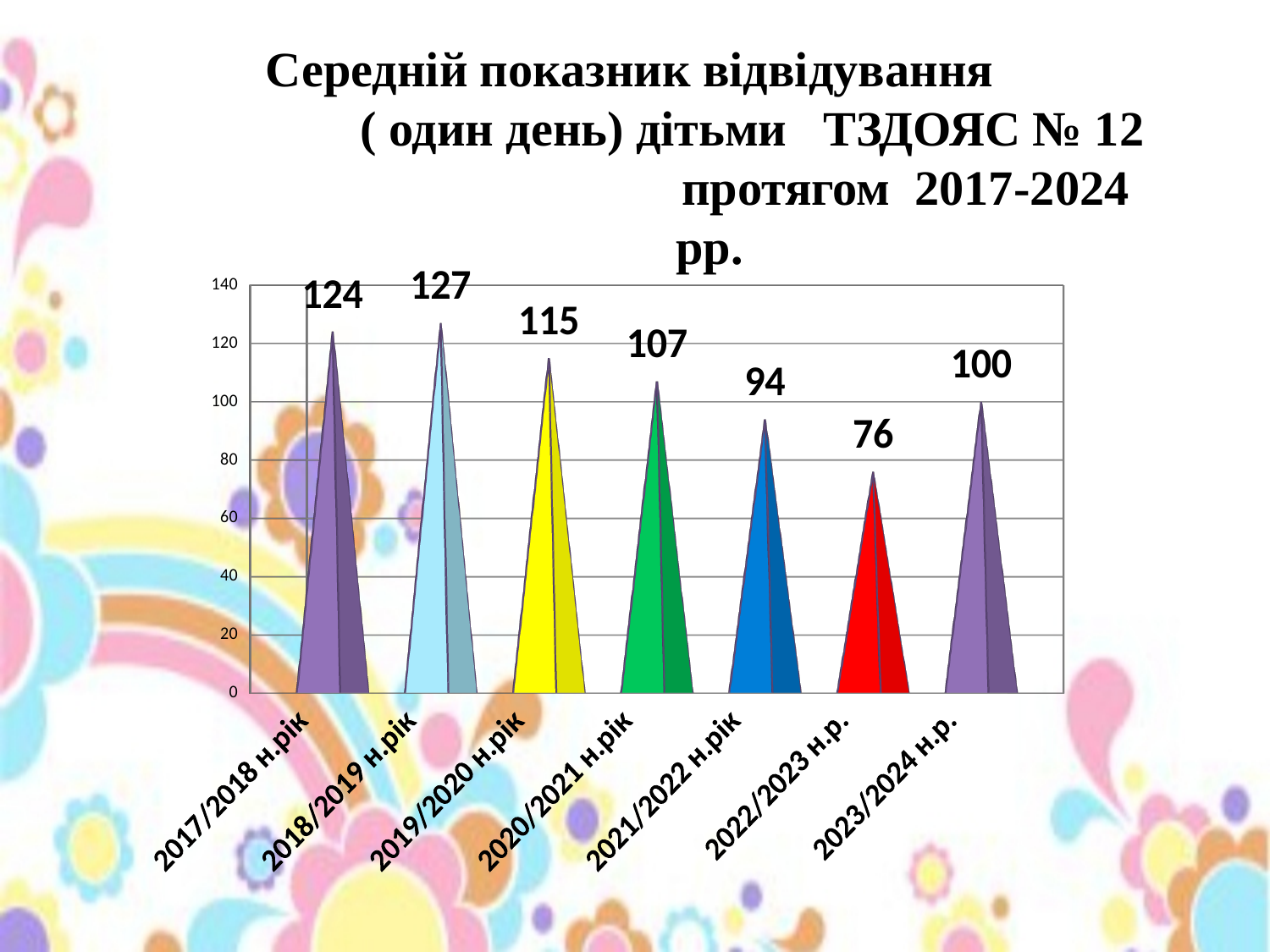
Is the value for 2020/2021 н.рік greater or less than 100? greater Which school year has the lowest average attendance? 2022/2023 н.р. Do the values rise or fall from 2018/2019 н.рік to 2022/2023 н.р.? fall Which school year has the highest average attendance? 2018/2019 н.рік What kind of chart is shown on the slide? bar chart How many school years are shown on the chart? 7 What is the value shown for 2023/2024 н.р.? 100 What is the value shown for 2021/2022 н.рік? 94 Which is larger, the value for 2021/2022 н.рік or the value for 2023/2024 н.р.? 2023/2024 н.р. What is the difference between the values for 2019/2020 н.рік and 2020/2021 н.рік? 8 What is the average attendance value for 2017/2018 н.рік? 124 What is the difference between the values for 2018/2019 н.рік and 2022/2023 н.р.? 51